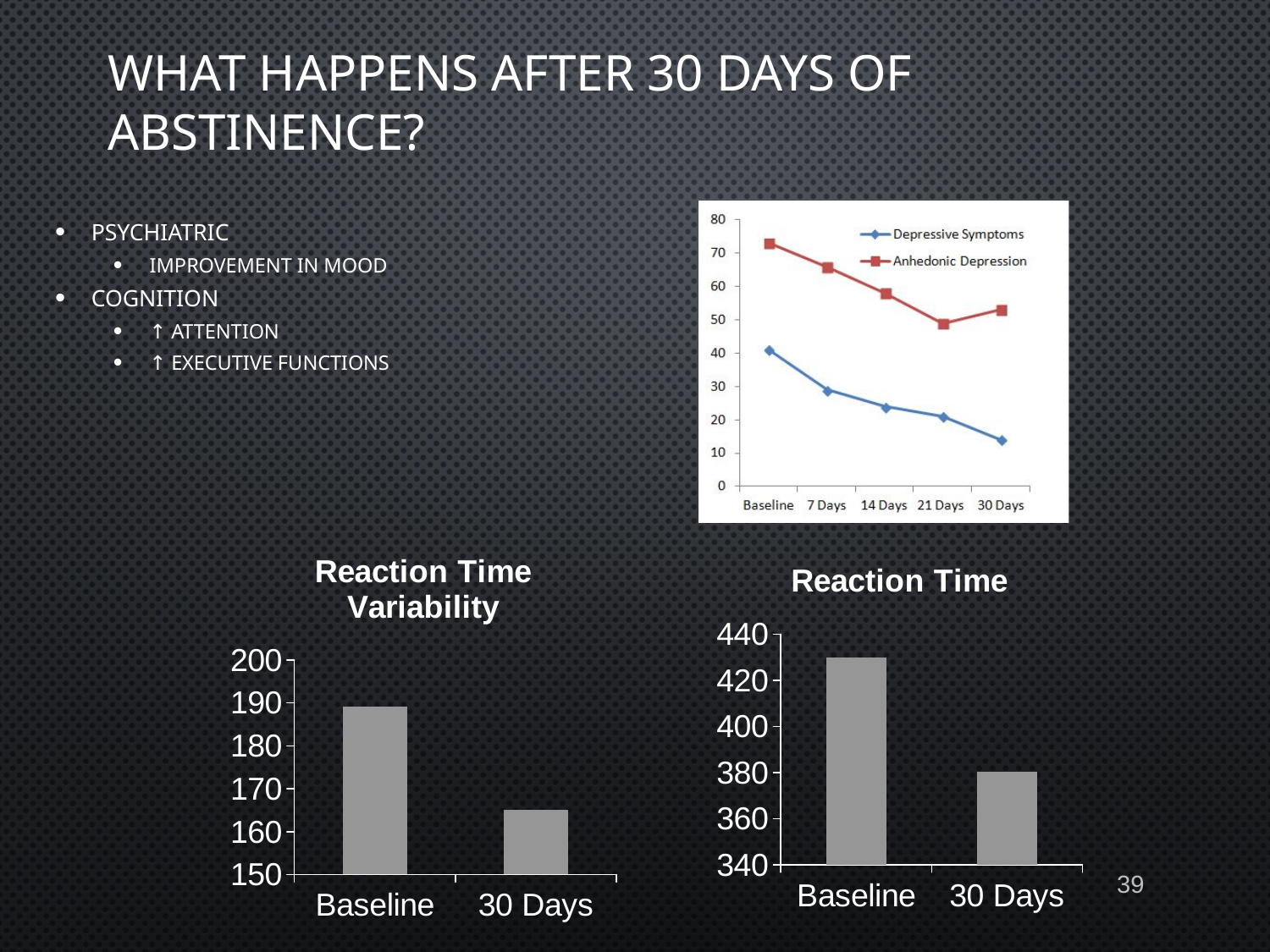
What kind of chart is the chart at the top right of the slide showing Depressive Symptoms and Anhedonic Depression? line chart In the 'Reaction Time' chart, is the value for Baseline greater or less than 420? greater In the top-right line chart, is the Anhedonic Depression value at Baseline greater or less than 70? greater In the top-right line chart, is the Depressive Symptoms value at 30 Days greater or less than 20? less In the top-right line chart, how many time points are shown on the x axis? 5 In the top-right line chart, do the Depressive Symptoms values rise or fall from Baseline to 30 Days? fall In the 'Reaction Time' chart, which category has the lower value, Baseline or 30 Days? 30 Days In the 'Reaction Time Variability' chart, which category has the higher value, Baseline or 30 Days? Baseline In the top-right line chart, how many series does the legend list? 2 What kind of chart is the 'Reaction Time' chart at the bottom right of the slide? bar chart In the top-right line chart, which series has the higher value at 14 Days, Depressive Symptoms or Anhedonic Depression? Anhedonic Depression